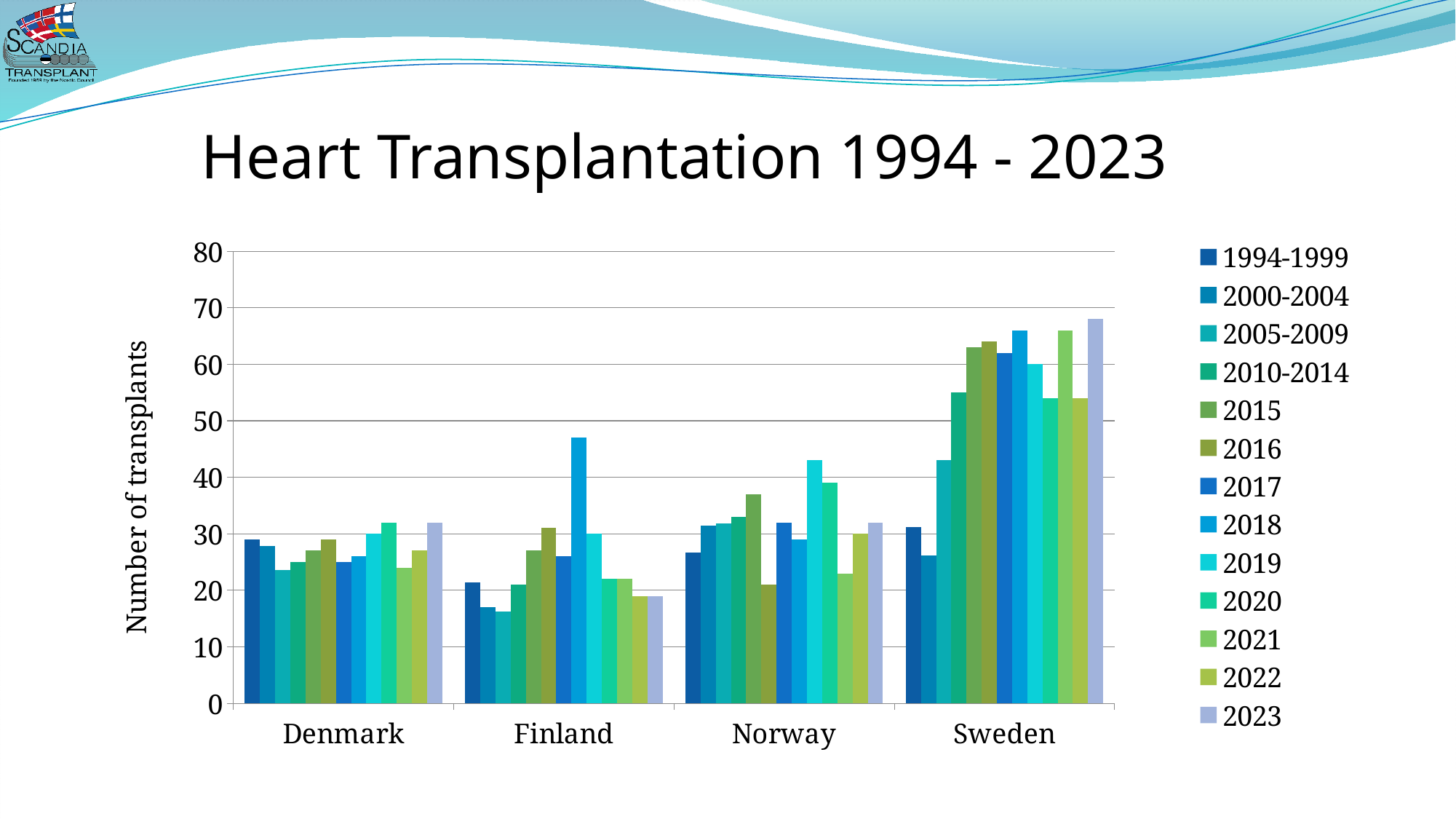
What is the title of the chart? Heart Transplantation 1994 - 2023 Which is larger, the value for Norway in 2016 or the value for Norway in 2015? Norway in 2015 Is the value for Sweden in 2023 greater or less than 60? greater How many countries are shown on the x axis? 4 Is the value for Finland in 2018 greater or less than 40? greater What is the label on the y axis? Number of transplants Which country has the highest number of heart transplants overall? Sweden How many series does the legend list? 13 Is the value for Norway in 2019 greater or less than 40? greater What kind of chart is shown on the slide? bar chart Which is larger, the value for Sweden in 2023 or the value for Sweden in 2022? Sweden in 2023